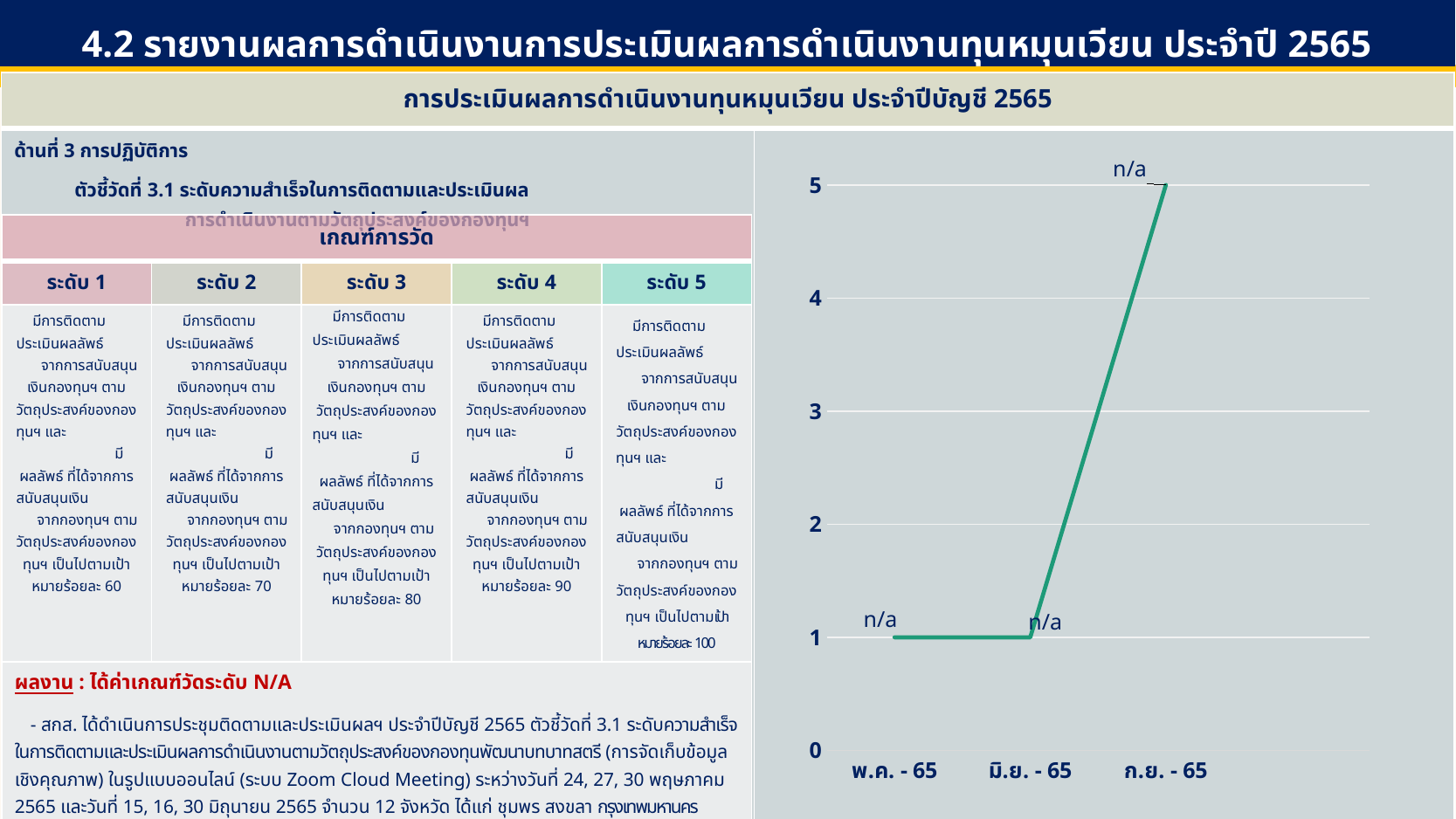
How many categories are shown on the x axis of the line chart? 3 Is the value for มิ.ย. - 65 greater or less than 3? less On which y-axis tick does the point for พ.ค. - 65 sit? 1 Which x-axis category has the highest point on the line chart? ก.ย. - 65 On which y-axis tick does the point for ก.ย. - 65 sit? 5 What data label is printed next to the point for ก.ย. - 65? n/a Which is larger on the line chart, the value for ก.ย. - 65 or the value for พ.ค. - 65? ก.ย. - 65 What type of chart is shown on the right side of the slide? line chart Is the value for พ.ค. - 65 greater or less than 2? less What is the highest tick value shown on the y axis of the line chart? 5 Is the value for ก.ย. - 65 greater or less than 4? greater Do the values on the line chart rise or fall from พ.ค. - 65 to ก.ย. - 65? rise